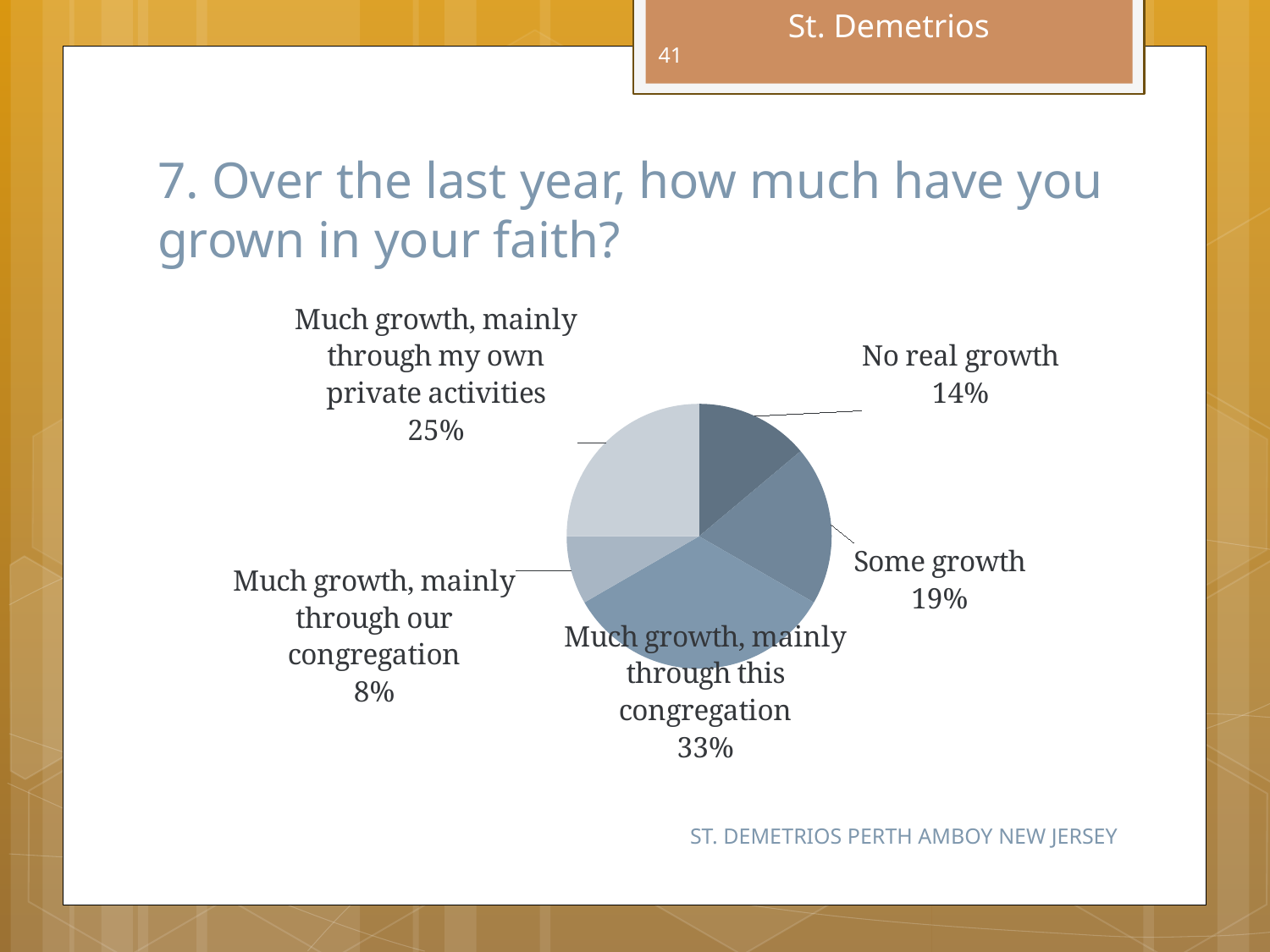
What percentage of respondents reported "Much growth, mainly through this congregation"? 33% What percentage of respondents reported "Much growth, mainly through our congregation"? 8% What percentage of respondents reported "Much growth, mainly through my own private activities"? 25% Which is larger: the share for "Some growth" or the share for "Much growth, mainly through my own private activities"? Much growth, mainly through my own private activities What question does the chart on the slide present responses to? 7. Over the last year, how much have you grown in your faith? What percentage of respondents reported "Some growth"? 19% Which category has the smallest share of the pie? Much growth, mainly through our congregation How many categories are shown in the pie chart? 5 What percentage of respondents reported "No real growth"? 14% Which category has the largest share of the pie? Much growth, mainly through this congregation What is the difference in percentage points between "Much growth, mainly through this congregation" and "No real growth"? 19 What kind of chart is shown on the slide? pie chart